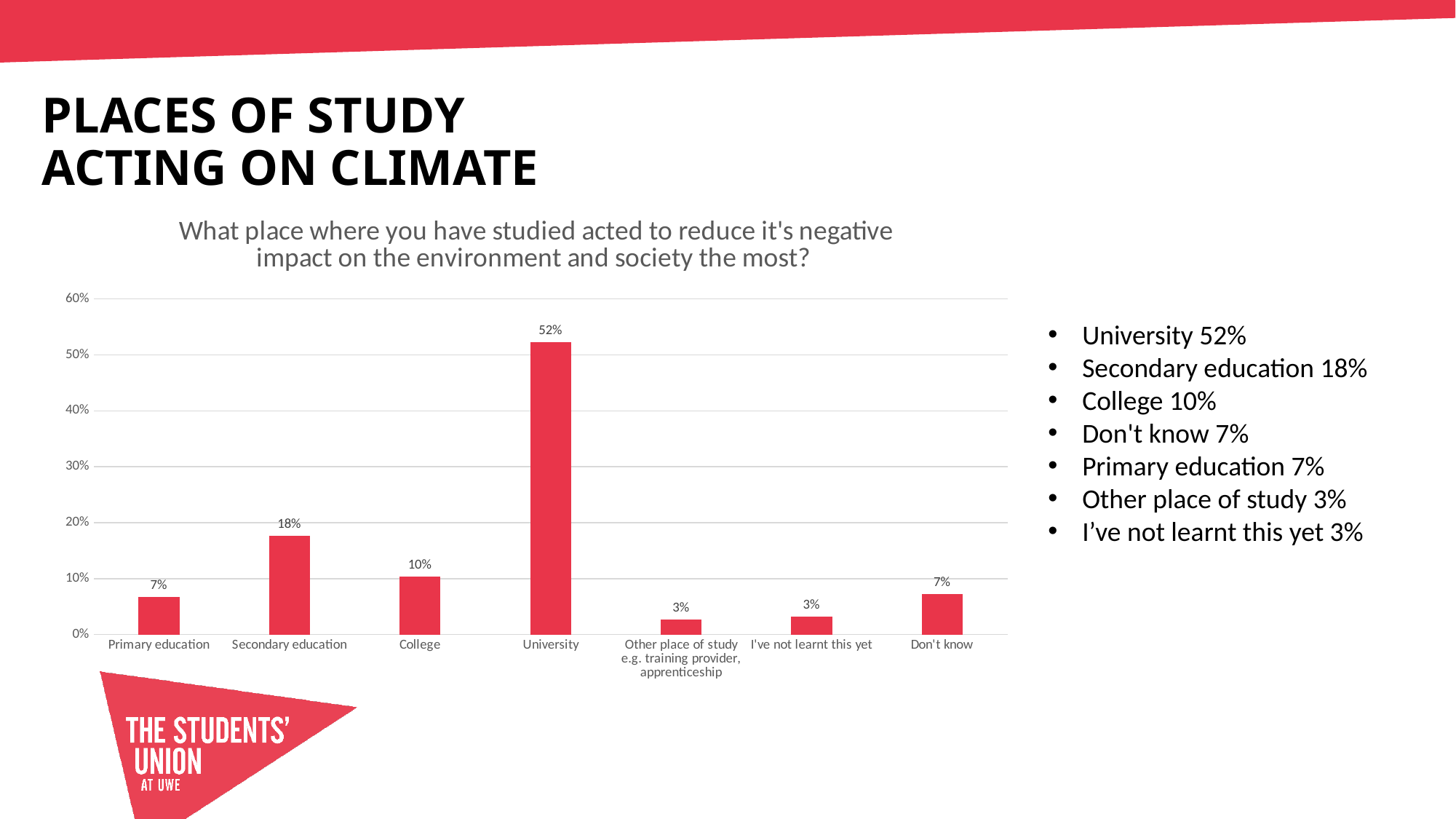
What is the title of the chart? What place where you have studied acted to reduce it's negative impact on the environment and society the most? Which category has the highest value? University What is the value for Secondary education? 18% What is the value for Primary education? 7% What kind of chart is shown on the slide? Bar chart What is the value for University? 52% Is the value for University greater or less than 50%? greater What is the value for College? 10% What is the difference between the values for University and Secondary education? 34% Which is larger, the value for College or the value for Don't know? College How many categories are shown on the x axis? 7 What is the difference between the values for Secondary education and College? 8%